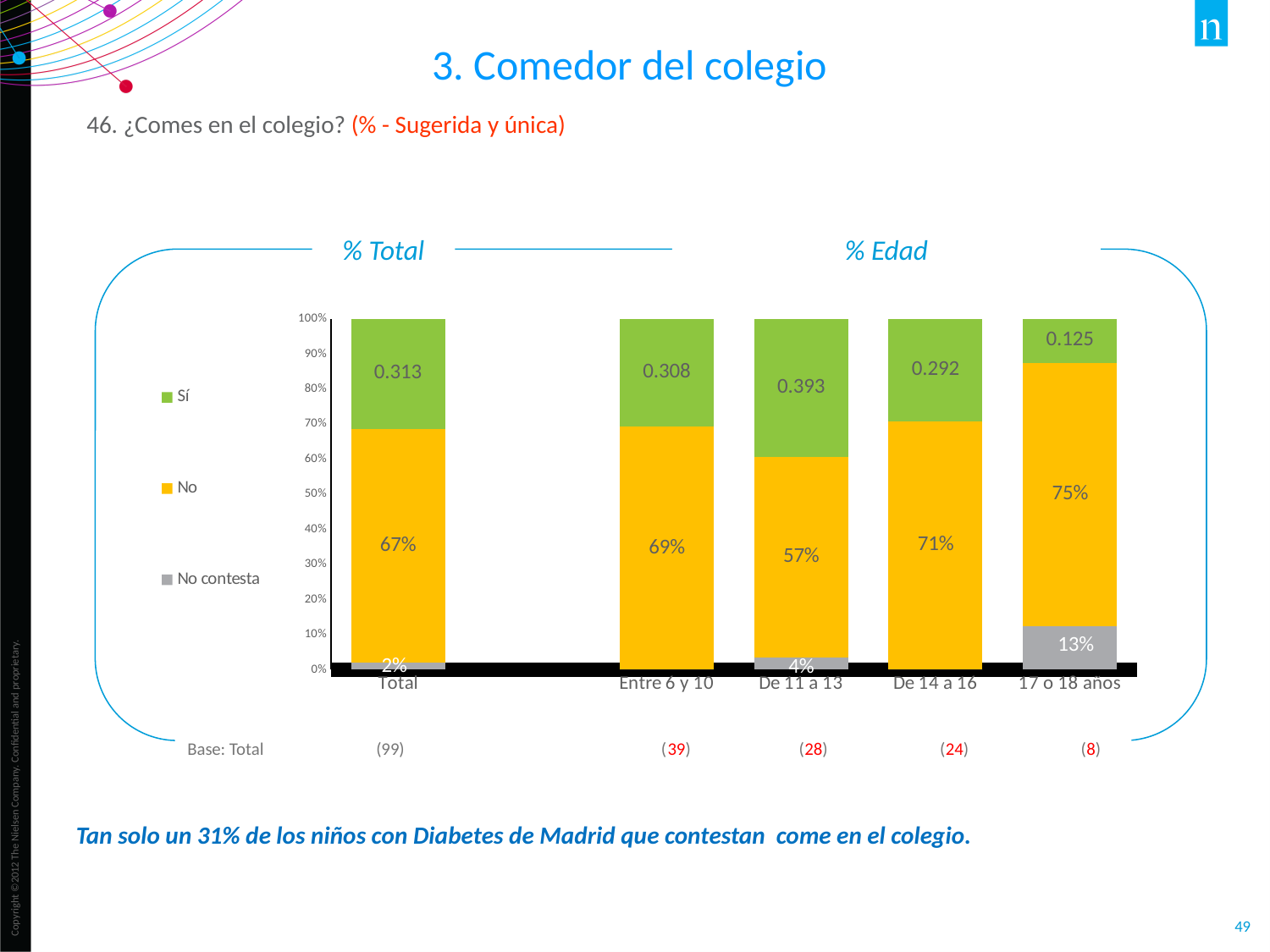
Which is larger: the 'Sí' value for 'Entre 6 y 10' or for 'De 11 a 13'? De 11 a 13 What is the value of the 'No' series for the 'De 14 a 16' category? 71% What is the value of the 'No' series for the 'Total' category? 67% How many series does the legend list? 3 Which category has the lowest value for the 'Sí' series? 17 o 18 años How many categories are shown along the x axis? 5 What type of chart is shown on the slide? stacked bar chart What is the difference between the 'No' values for 'De 14 a 16' and 'De 11 a 13'? 14% Which series is shown in green in the legend? Sí What is the value of the 'No contesta' series for the '17 o 18 años' category? 13% Which category has the highest value for the 'No' series? 17 o 18 años What is the value of the 'Sí' series for the 'De 11 a 13' category? 0.393